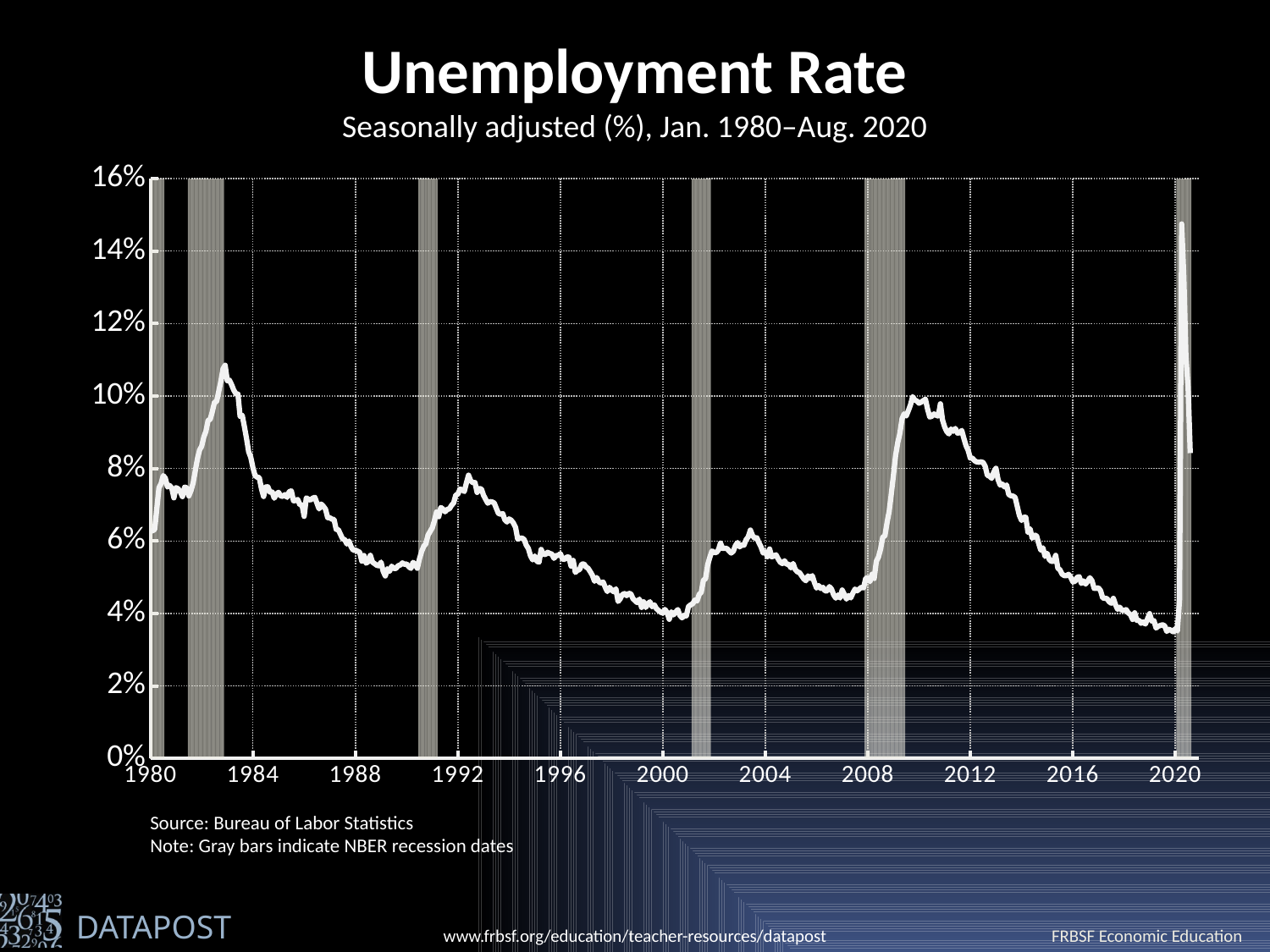
Is the peak unemployment rate around 2010 greater or less than 8%? greater What is the title of the chart? Unemployment Rate Is the peak unemployment rate around 1992 greater or less than 6%? greater Is the unemployment rate in 2019 greater or less than 4%? less What kind of chart is shown on the slide? line chart Does the unemployment rate rise or fall between 1992 and 2000? fall In which year does the unemployment rate reach its highest point on the chart? 2020 Does the unemployment rate rise or fall between 2010 and 2019? fall What period does the chart's subtitle say the data covers? Jan. 1980–Aug. 2020